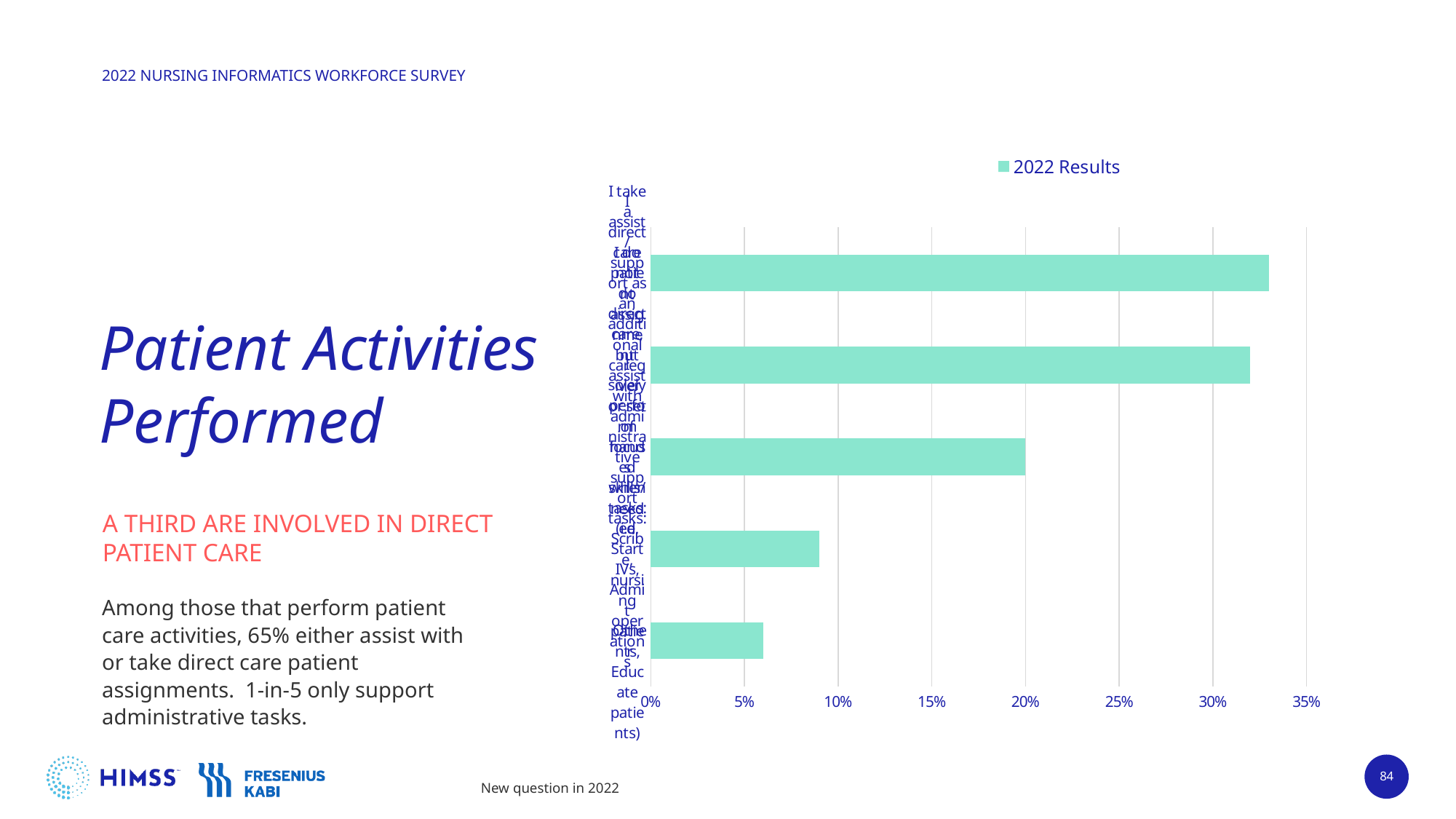
What is the highest value shown on the chart's horizontal axis? 35% What is the legend entry for the series in the chart? 2022 Results Which bar is the shortest in the chart, by position? the bottom bar Is the value of the second bar from the top greater or less than 25%? greater How many bars are plotted in the chart? 5 Is the value of the top bar greater or less than 30%? greater How many series does the chart legend list? 1 What value does the third bar from the top reach on the axis? 20% Which bar is the longest in the chart: the top bar or the bottom bar? the top bar Is the value of the bottom bar greater or less than 5%? greater What kind of chart is shown on the slide? bar chart